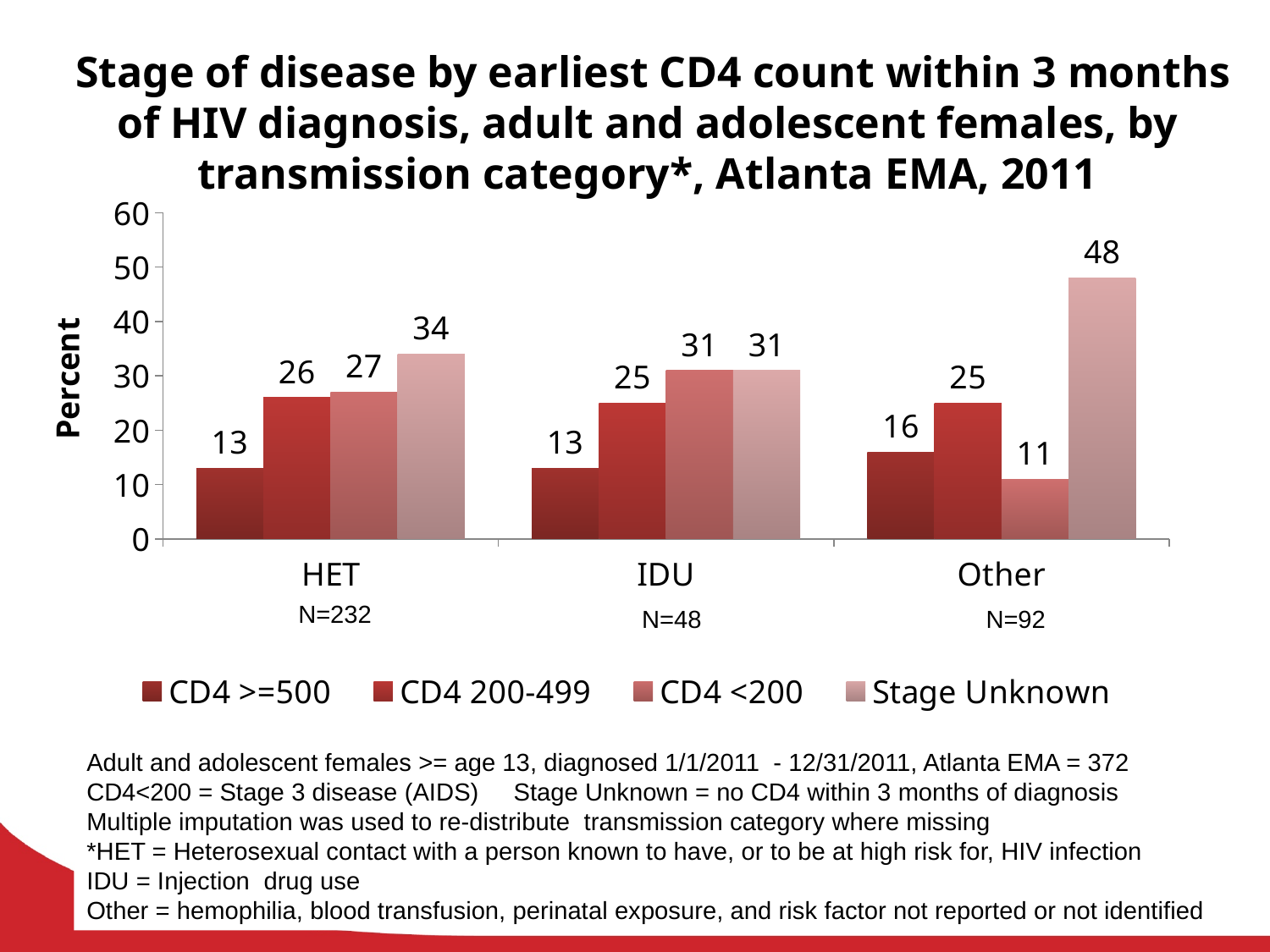
What is the value for CD4 >=500 in the HET category? 13 How many transmission categories are shown on the x axis? 3 What is the label of the y axis? Percent What is the value for CD4 200-499 in the Other category? 25 What is the value for Stage Unknown in the Other category? 48 What is the value for CD4 <200 in the IDU category? 31 Which is larger: CD4 >=500 for Other or CD4 >=500 for HET? CD4 >=500 for Other What kind of chart is shown on the slide? Bar chart Which transmission category has the lowest CD4 <200 value? Other How many series does the legend list? 4 What is the difference between the Stage Unknown value and the CD4 <200 value in the Other category? 37 Which transmission category has the highest Stage Unknown value? Other